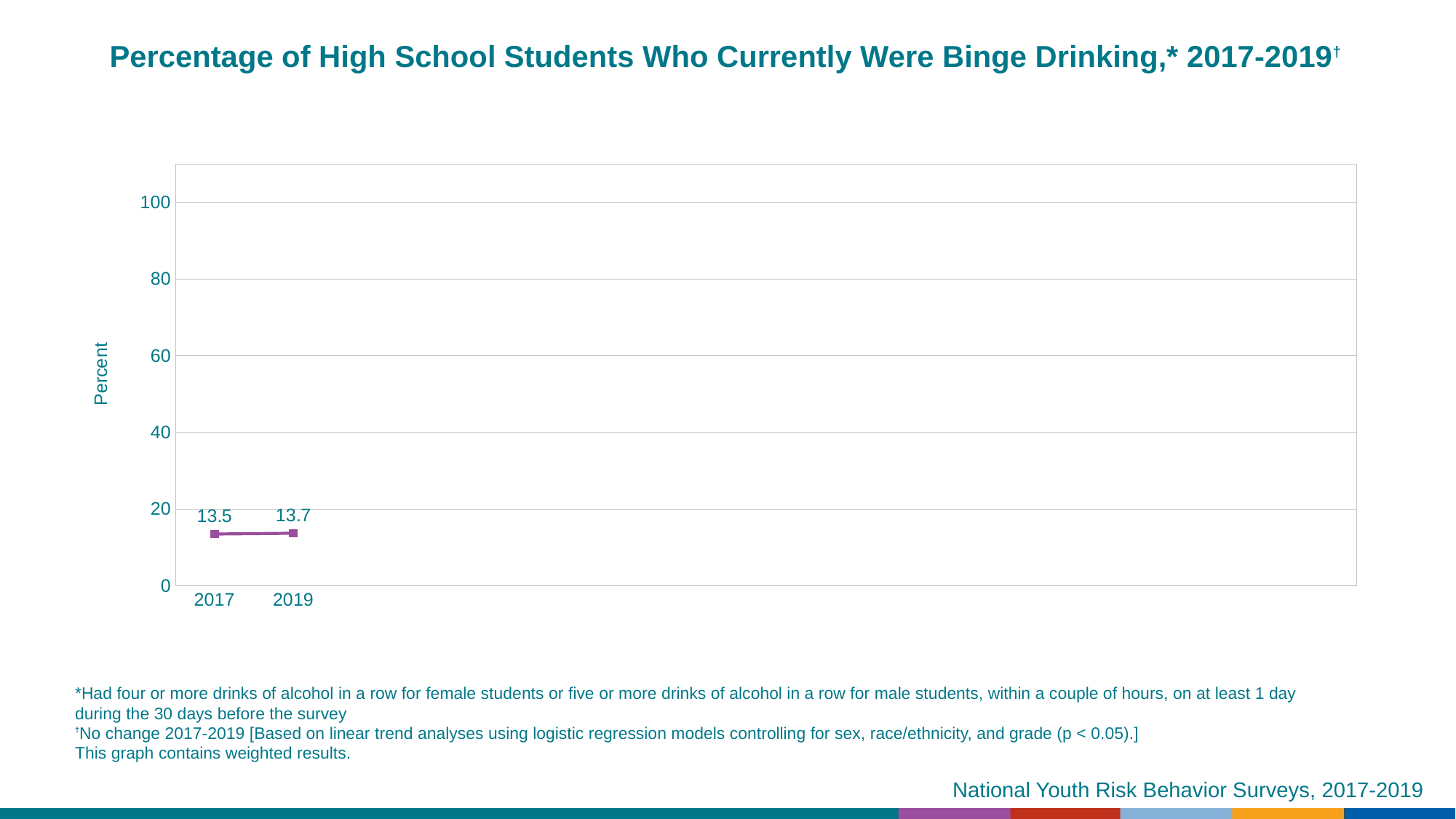
What kind of chart is shown on the slide? line chart What is the label on the y axis? Percent What is the difference between the 2019 and 2017 values? 0.2 What is the value for 2017? 13.5 Do the values rise or fall from 2017 to 2019? rise Is the value for 2019 greater or less than 20? less What is the highest value shown on the y axis? 100 What is the value for 2019? 13.7 What is the title of the chart? Percentage of High School Students Who Currently Were Binge Drinking,* 2017-2019 Is the value for 2017 greater or less than 20? less How many data points are plotted on the chart? 2 Which year has the higher value, 2017 or 2019? 2019